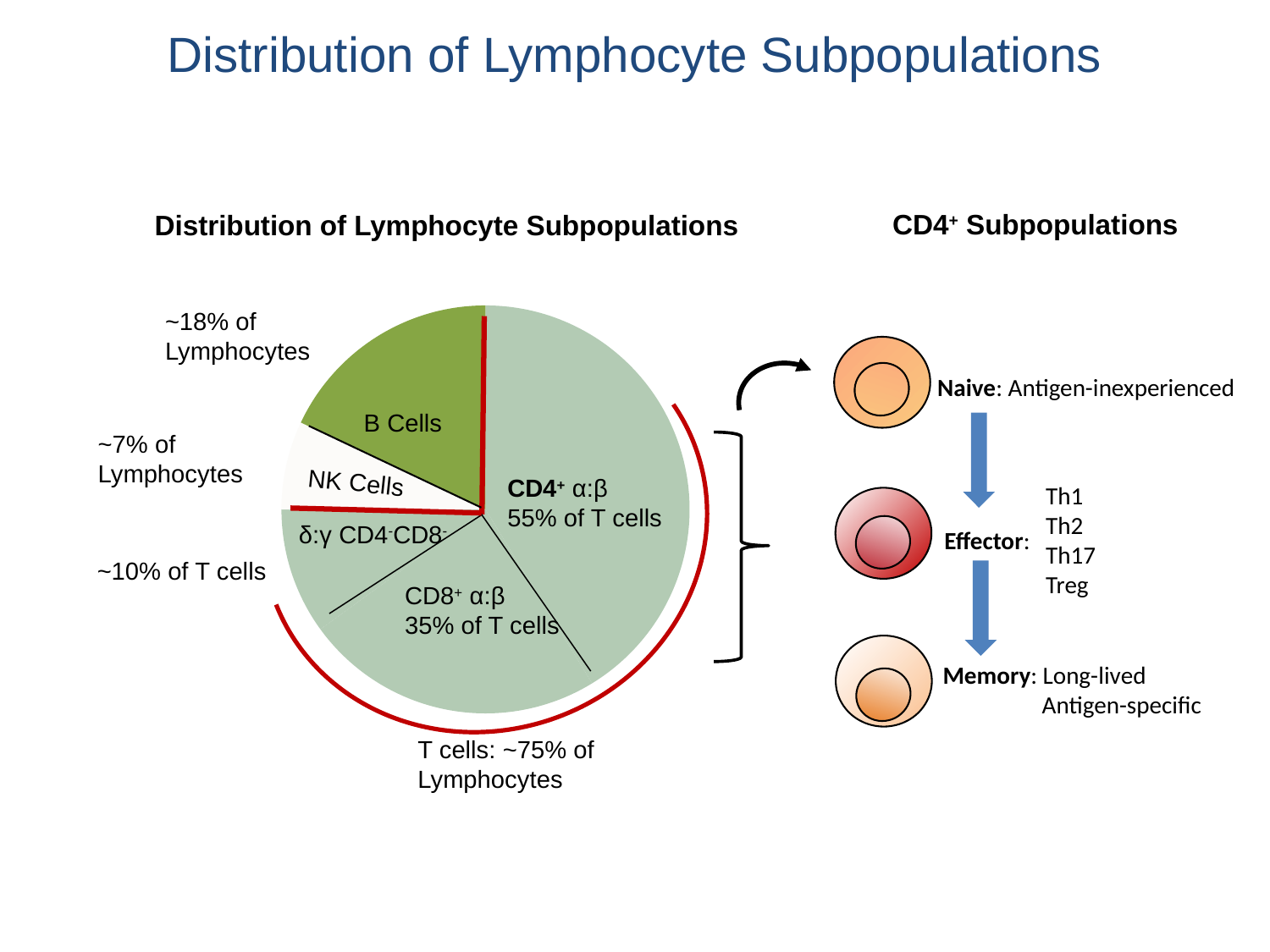
What is the title of the pie chart on the left of the slide? Distribution of Lymphocyte Subpopulations What percentage of T cells are CD8+ α:β cells according to the pie chart? 35% of T cells What percentage of T cells are δ:γ CD4-CD8- cells according to the pie chart? ~10% of T cells By how many percentage points does the CD4+ α:β share of T cells exceed the CD8+ α:β share? 20 percentage points According to the pie chart, what share of lymphocytes are B cells? ~18% According to the pie chart, what share of lymphocytes are T cells? ~75% Which slice of the pie chart is the largest? CD4+ α:β What kind of chart is shown on the slide? Pie chart How many slices does the pie chart have? 5 What percentage of T cells are CD4+ α:β cells according to the pie chart? 55% of T cells Which is the larger slice of the pie chart, B Cells or NK Cells? B Cells According to the pie chart, what share of lymphocytes are NK cells? ~7%